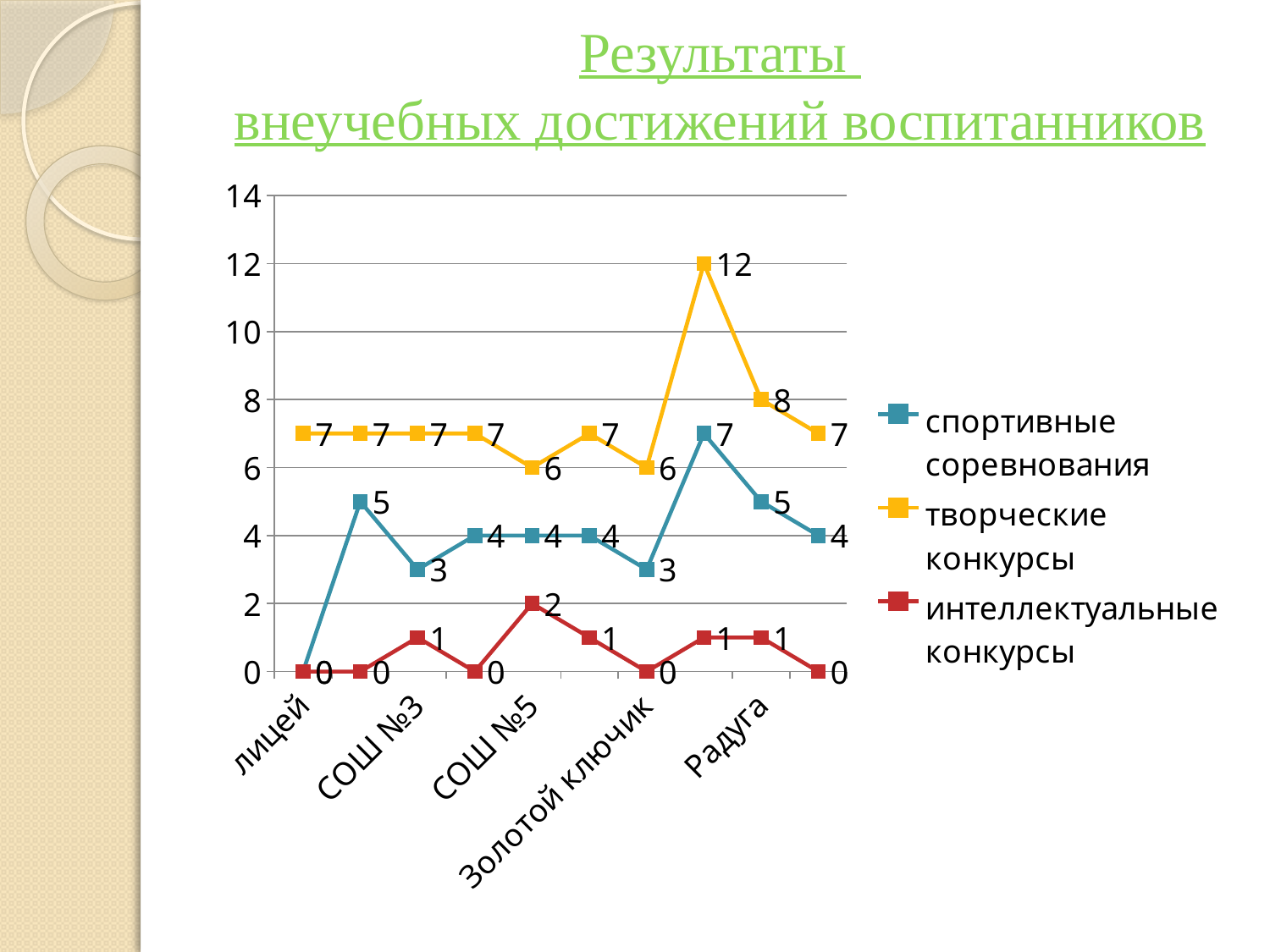
What is the value of спортивные соревнования for СОШ №5? 4 What is the value of спортивные соревнования for лицей? 0 What is the highest value plotted for творческие конкурсы? 12 Which series is shown in red in the legend? интеллектуальные конкурсы What is the value of интеллектуальные конкурсы for СОШ №5? 2 What is the highest value plotted for интеллектуальные конкурсы? 2 What is the difference between творческие конкурсы and спортивные соревнования at Золотой ключик? 3 What kind of chart is shown on the slide? line chart Is the value of творческие конкурсы for лицей greater or less than 6? greater Which series has the highest value at Радуга? творческие конкурсы How many series does the legend list? 3 What is the value of творческие конкурсы for Радуга? 8